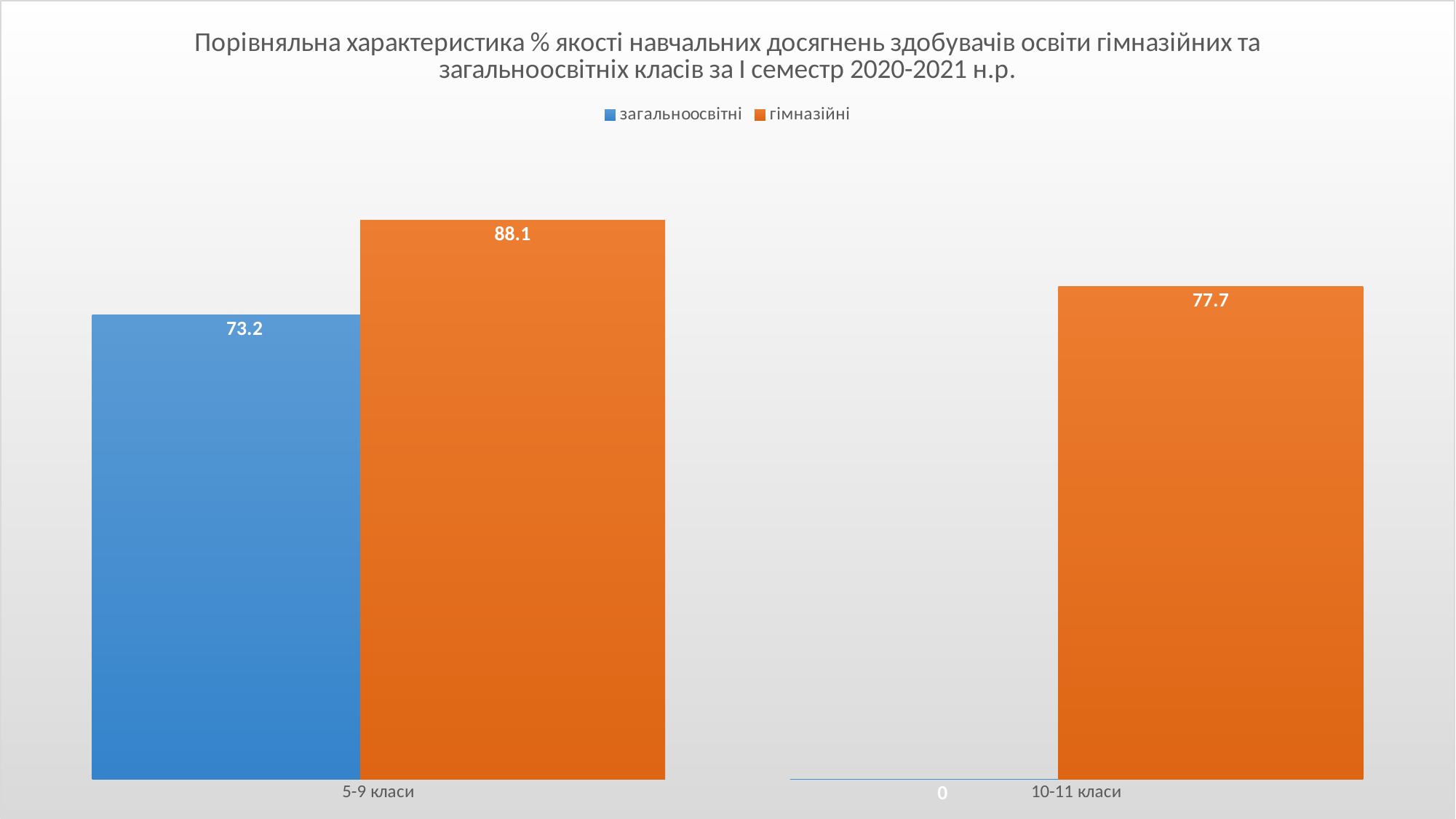
What is the value for гімназійні in the 5-9 класи category? 88.1 What is the value for загальноосвітні in the 10-11 класи category? 0 Which category has the lowest value for the загальноосвітні series? 10-11 класи What kind of chart is shown on the slide? Bar chart Which category has the highest value for the гімназійні series? 5-9 класи How many categories are shown on the x axis? 2 What is the difference between the гімназійні and загальноосвітні values for 5-9 класи? 14.9 How many series does the legend list? 2 Which is larger for 5-9 класи: загальноосвітні or гімназійні? гімназійні What is the value for загальноосвітні in the 5-9 класи category? 73.2 What is the value for гімназійні in the 10-11 класи category? 77.7 What is the difference between the гімназійні values for 5-9 класи and 10-11 класи? 10.4